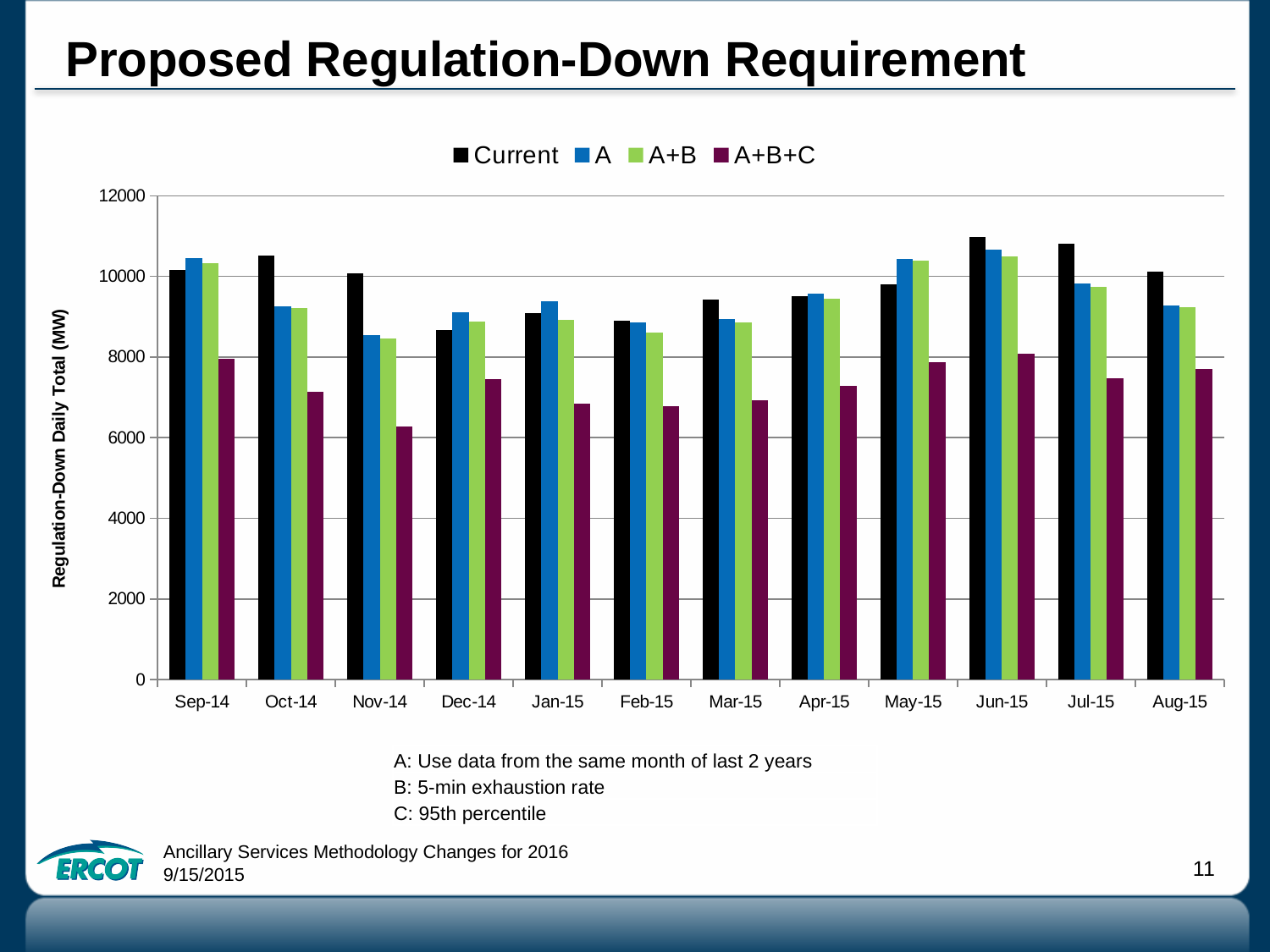
Which month has the highest Current value? Jun-15 What kind of chart is shown on the slide? bar chart Which is larger in Mar-15, the Current value or the A+B+C value? Current What is the label on the y axis? Regulation-Down Daily Total (MW) Is the Current value for Sep-14 greater or less than 10000? greater Which month has the lowest Current value? Dec-14 Which month has the lowest A+B+C value? Nov-14 Is the A value for Jun-15 greater or less than 10000? greater Is the A+B+C value for Nov-14 greater or less than 8000? less Which is larger, the Current value for Oct-14 or the Current value for Dec-14? Oct-14 How many series does the legend list? 4 How many months are shown along the x axis? 12